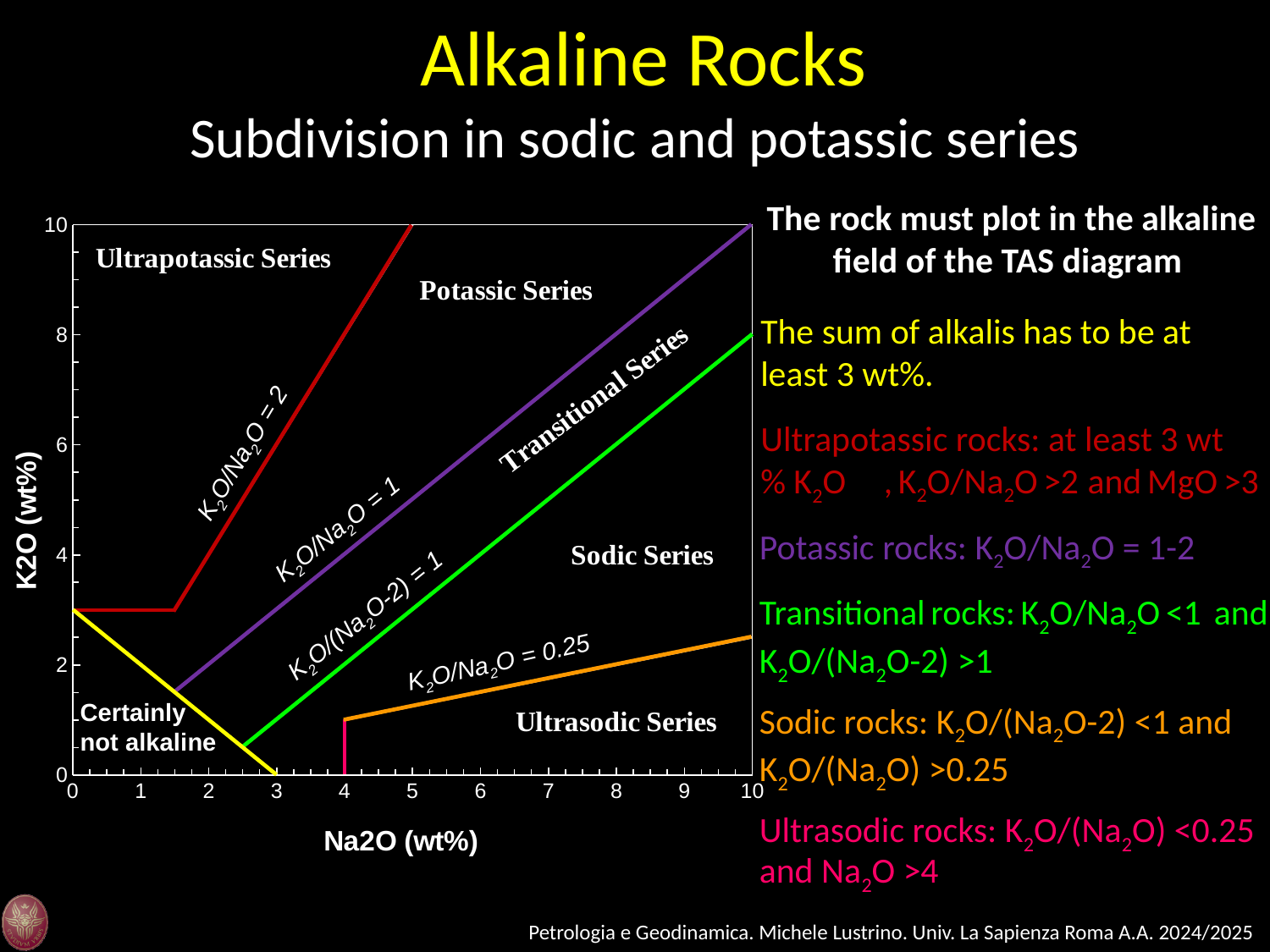
What is the maximum value shown on the y axis of the chart? 10 What is the label of the y axis of the chart? K2O (wt%) What is the label of the x axis of the chart? Na2O (wt%) Which series field occupies the bottom-right corner of the chart? Ultrasodic Series How many named series fields (regions) are labelled inside the chart, including 'Certainly not alkaline'? 6 Is the K2O value of the orange K2O/Na2O = 0.25 line at Na2O = 10 greater or less than 2? greater At what Na2O value does the vertical magenta boundary line of the Ultrasodic Series stand? 4 Which series field occupies the top-left corner of the chart? Ultrapotassic Series What kind of chart is shown on the slide? line chart At what Na2O value does the yellow boundary line reach the x axis (K2O = 0)? 3 What K2O value does the green K2O/(Na2O-2) = 1 line reach at Na2O = 10? 8 At what Na2O value does the red K2O/Na2O = 2 line reach the top of the chart (K2O = 10)? 5